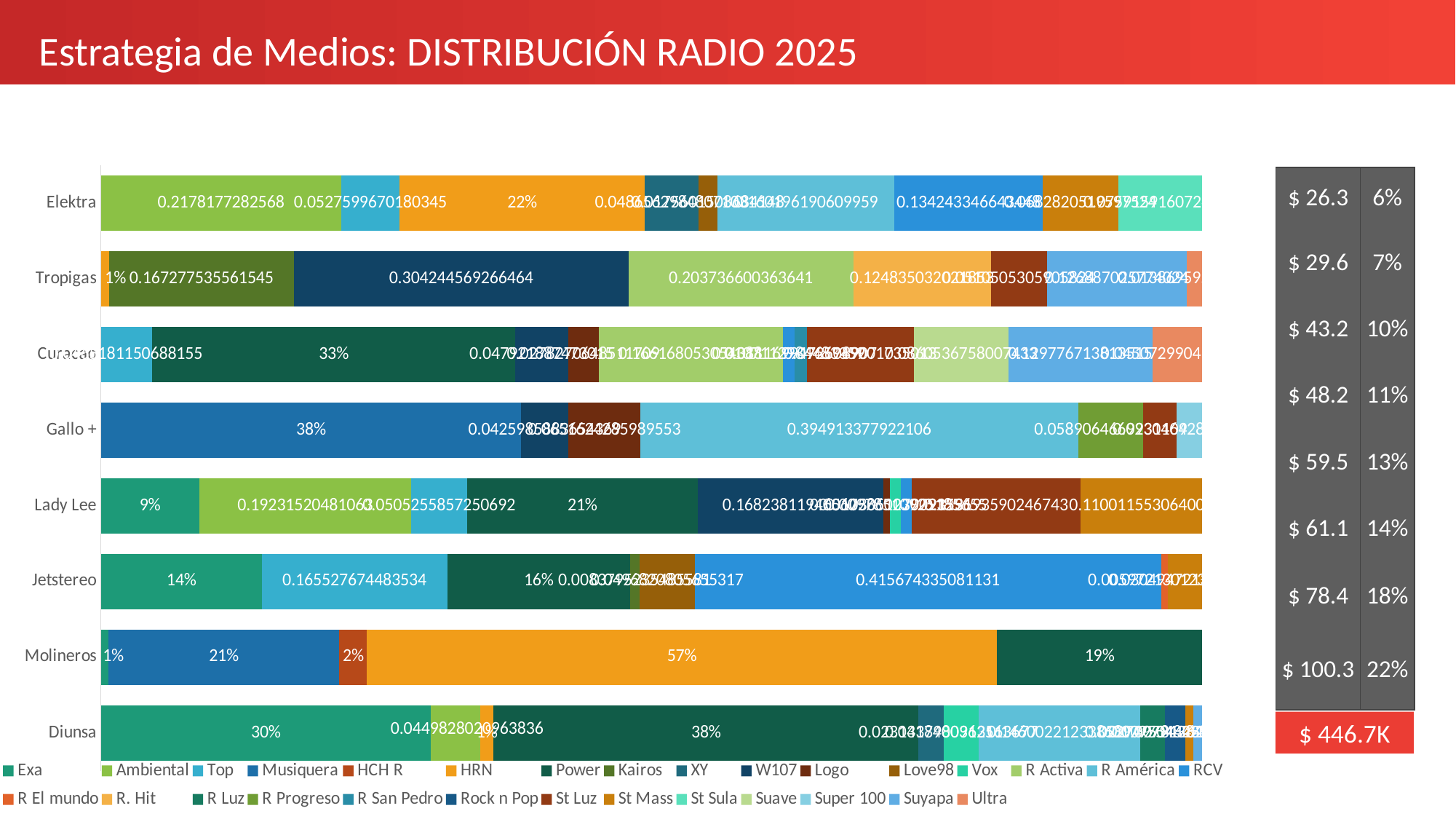
What kind of chart is shown on the slide? Stacked bar chart What is the value of the Exa segment for Diunsa? 30% What is the value of the Power segment for Molineros? 19% For Molineros, what is the difference between the HRN segment and the Power segment? 38 percentage points What is the value of the Musiquera segment for Molineros? 21% What is the value of the HRN segment for Molineros? 57% For Diunsa, which segment is larger: Power or Exa? Power What is the value of the Musiquera segment for Gallo +? 38% How many series does the chart legend list? 29 How many categories (companies) are plotted on the vertical axis of the chart? 8 What is the value of the Exa segment for Jetstereo? 14%